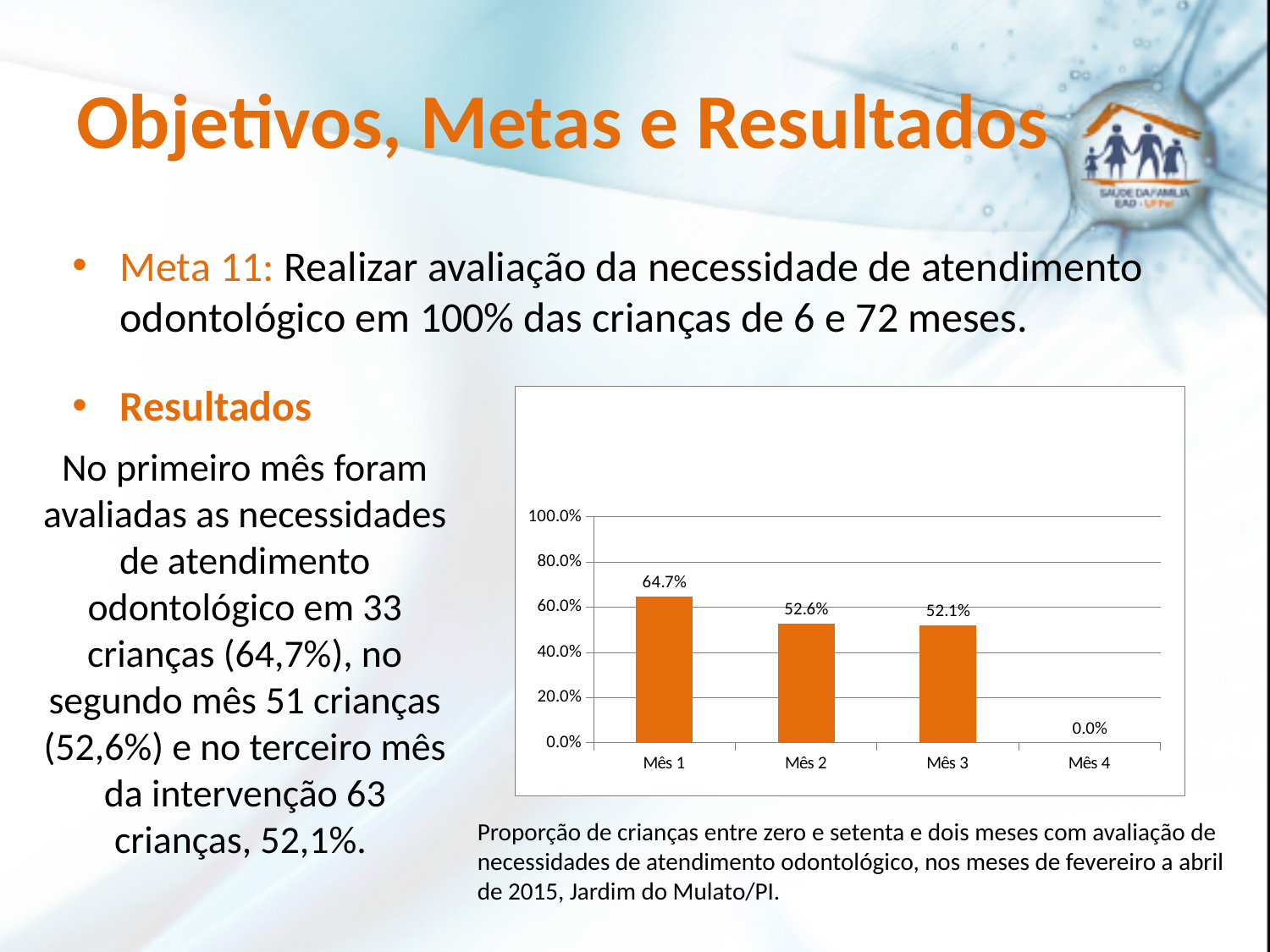
What is the value shown for Mês 3? 52.1% Do the values rise or fall from Mês 1 to Mês 4? Fall Which is larger, the value for Mês 1 or the value for Mês 3? Mês 1 What is the value shown for Mês 2? 52.6% What is the value shown for Mês 4? 0.0% What kind of chart is shown on the slide? Bar chart What is the difference between the values for Mês 2 and Mês 3? 0.5% What is the difference between the values for Mês 1 and Mês 2? 12.1% Which month has the highest value in the chart? Mês 1 Which month has the lowest value in the chart? Mês 4 How many months (categories) are shown on the x axis of the chart? 4 What is the value shown for Mês 1? 64.7%